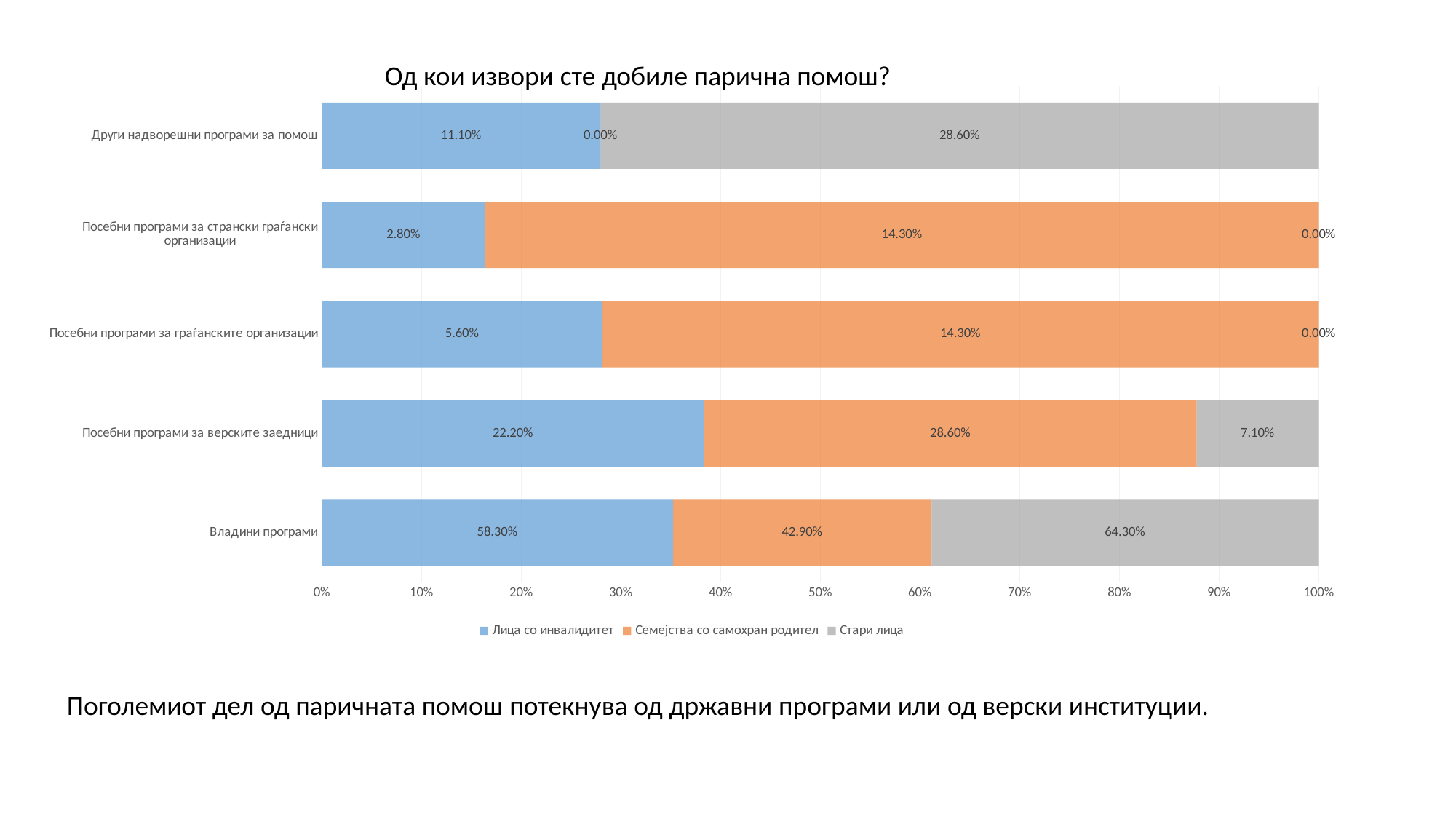
What is the value for Семејства со самохран родител in the Посебни програми за верските заедници category? 28.60% What is the value for Стари лица in the Други надворешни програми за помош category? 28.60% In the Посебни програми за верските заедници category, which is larger: the value for Лица со инвалидитет or for Семејства со самохран родител? Семејства со самохран родител What is the difference between the Лица со инвалидитет values for Посебни програми за граѓанските организации and Посебни програми за странски граѓански организации? 2.80% What is the title of the chart? Од кои извори сте добиле парична помош? Which category has the lowest value for Лица со инвалидитет? Посебни програми за странски граѓански организации What type of chart is shown on the slide? Stacked bar chart What is the value for Лица со инвалидитет in the Владини програми category? 58.30% What is the difference between the Стари лица value and the Семејства со самохран родител value in the Владини програми category? 21.40% Which category has the highest value for Стари лица? Владини програми How many series does the legend list? 3 How many categories are shown on the vertical axis? 5